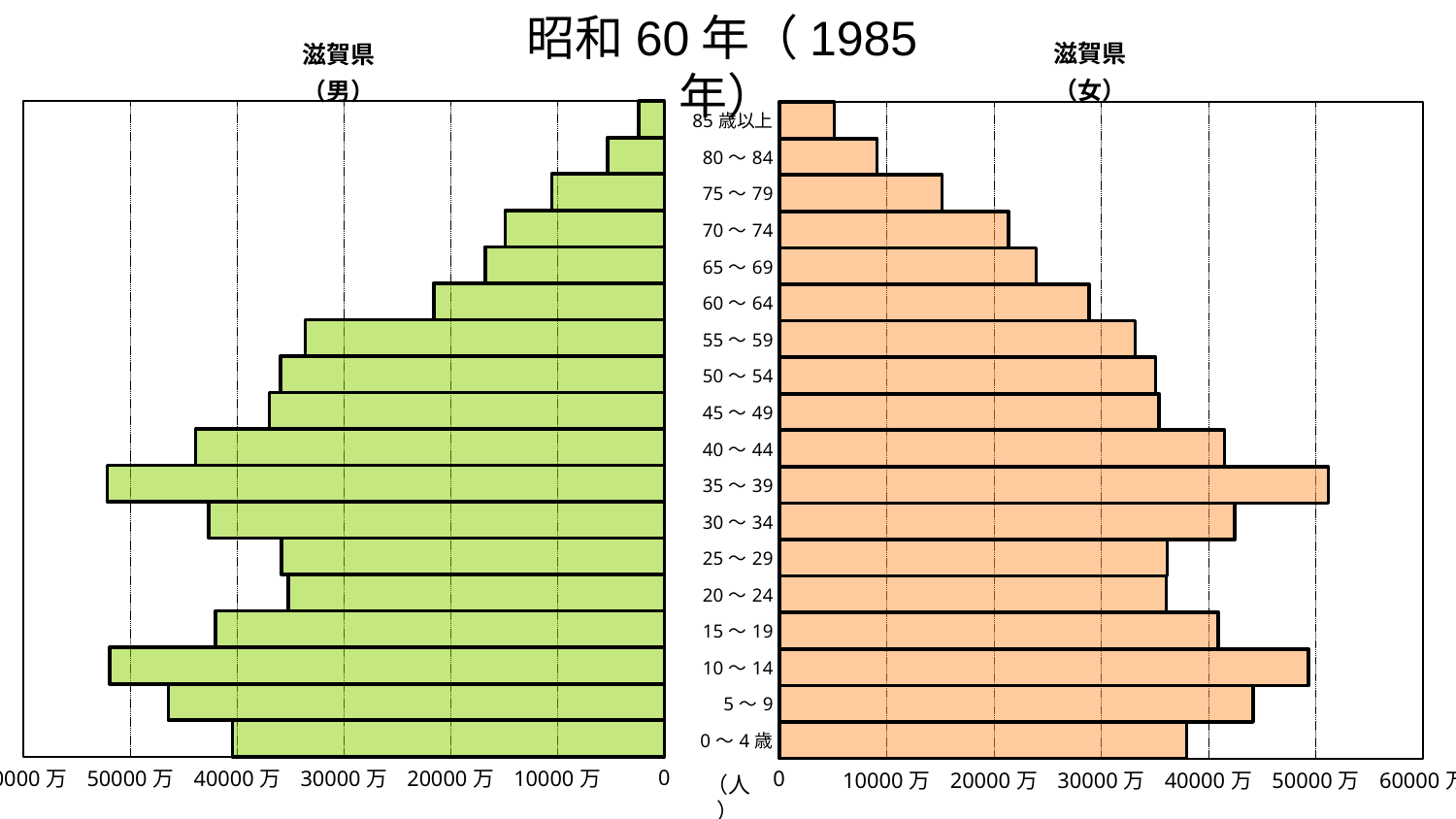
What is the title shown at the top of the slide? 昭和 60 年（1985 年） In the left chart (滋賀県（男）), is the value for 60～64 greater or less than 30000万? less In the left chart (滋賀県（男）), is the value for 5～9 greater or less than 40000万? greater In the right chart (滋賀県（女）), is the value for 85歳以上 greater or less than 10000万? less How many age groups are plotted in the right chart (滋賀県（女）)? 18 In the left chart (滋賀県（男）), which is larger, the value for 35～39 or the value for 20～24? 35～39 In the right chart (滋賀県（女）), which age group has the smallest value? 85歳以上 In the left chart (滋賀県（男）), which age group has the smallest value? 85歳以上 In the right chart (滋賀県（女）), which is larger, the value for 35～39 or the value for 30～34? 35～39 What kind of chart is shown on the left (滋賀県（男）)? bar chart